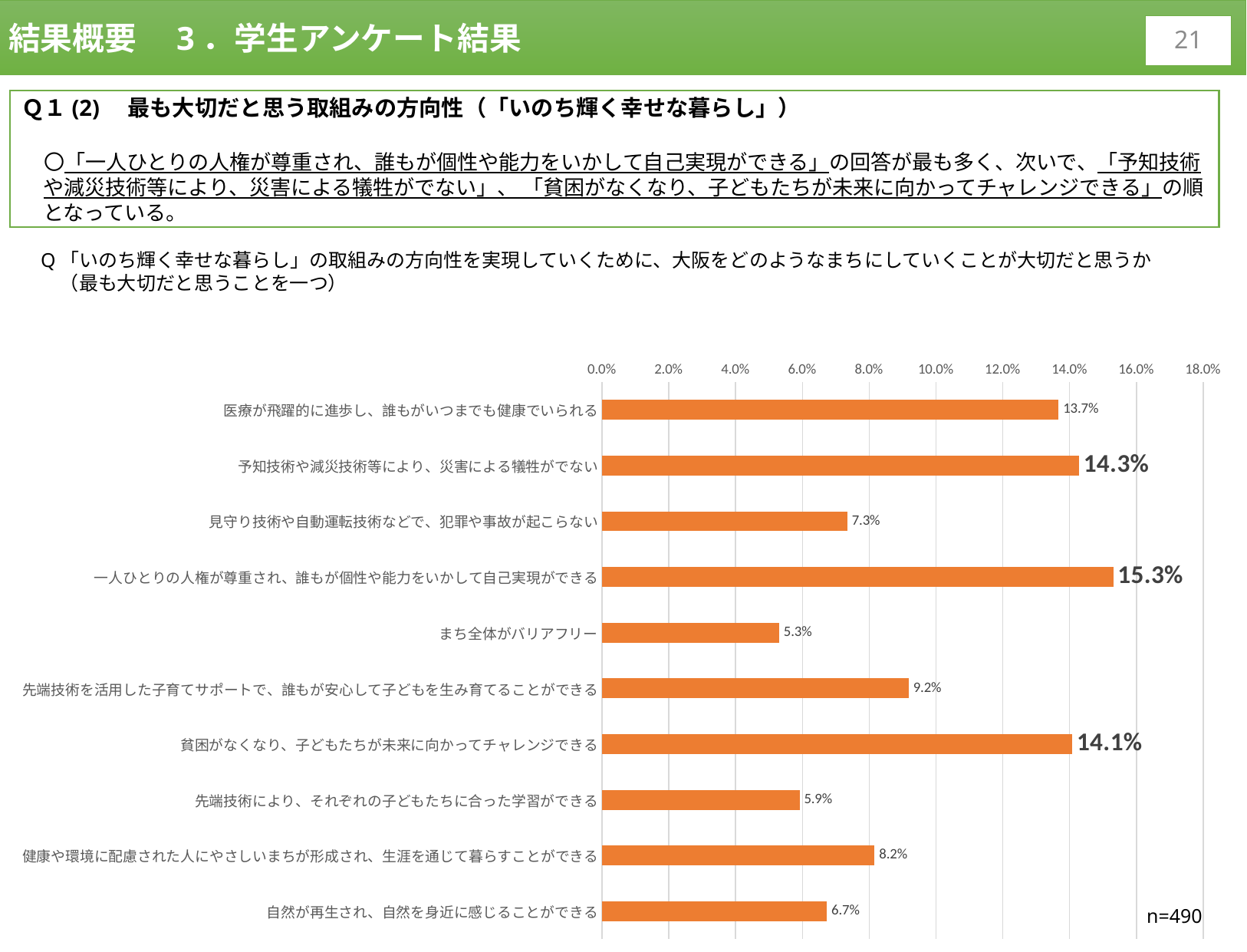
What is the value for 「先端技術を活用した子育てサポートで、誰もが安心して子どもを生み育てることができる」? 9.2% What is the value for 「まち全体がバリアフリー」? 5.3% Which category has the highest value? 一人ひとりの人権が尊重され、誰もが個性や能力をいかして自己実現ができる How many categories are shown in the chart? 10 What kind of chart is shown on the slide? bar chart What is the value shown for 「自然が再生され、自然を身近に感じることができる」? 6.7% What is the sample size (n) shown next to the chart? n=490 Which category has the lowest value? まち全体がバリアフリー What is the difference between the values for 「一人ひとりの人権が尊重され、誰もが個性や能力をいかして自己実現ができる」 and 「貧困がなくなり、子どもたちが未来に向かってチャレンジできる」? 1.2% Which is larger: the value for 「医療が飛躍的に進歩し、誰もがいつまでも健康でいられる」 or for 「貧困がなくなり、子どもたちが未来に向かってチャレンジできる」? 貧困がなくなり、子どもたちが未来に向かってチャレンジできる What percentage of respondents chose 「予知技術や減災技術等により、災害による犠牲がでない」? 14.3% Is the value for 「見守り技術や自動運転技術などで、犯罪や事故が起こらない」 greater or less than 8.0%? less